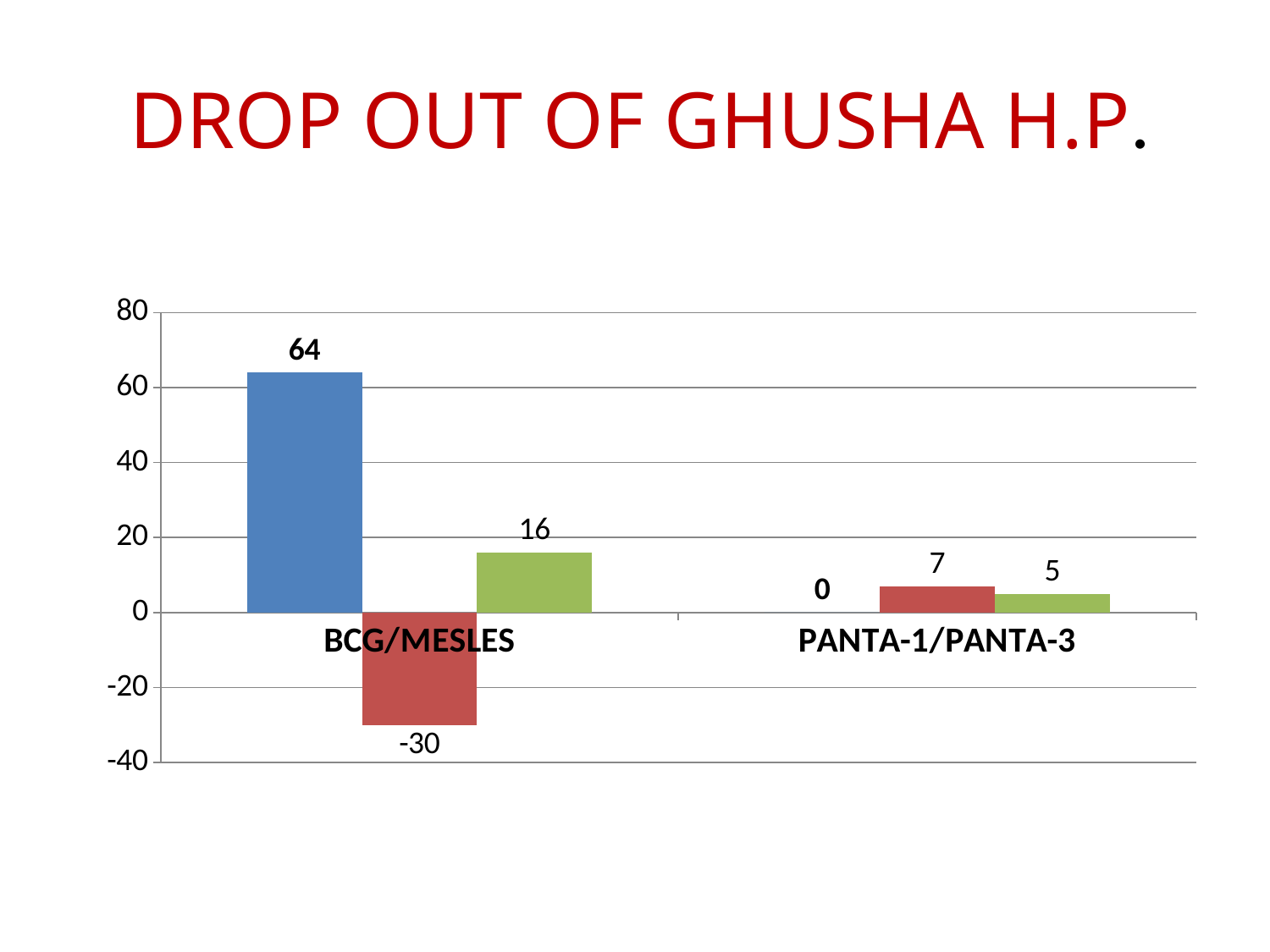
What is the value of the red bar for PANTA-1/PANTA-3? 7 What is the value of the blue bar for BCG/MESLES? 64 What is the value of the green bar for PANTA-1/PANTA-3? 5 Which bar has the highest value in the chart? The blue bar for BCG/MESLES (64) How many categories are shown on the x axis? 2 What is the lowest value shown in the chart? -30 What is the difference between the blue bar and the green bar for BCG/MESLES? 48 What is the value of the blue bar for PANTA-1/PANTA-3? 0 What is the value of the red bar for BCG/MESLES? -30 What type of chart is shown on the slide? Bar chart Which category has the larger green bar, BCG/MESLES or PANTA-1/PANTA-3? BCG/MESLES What is the value of the green bar for BCG/MESLES? 16